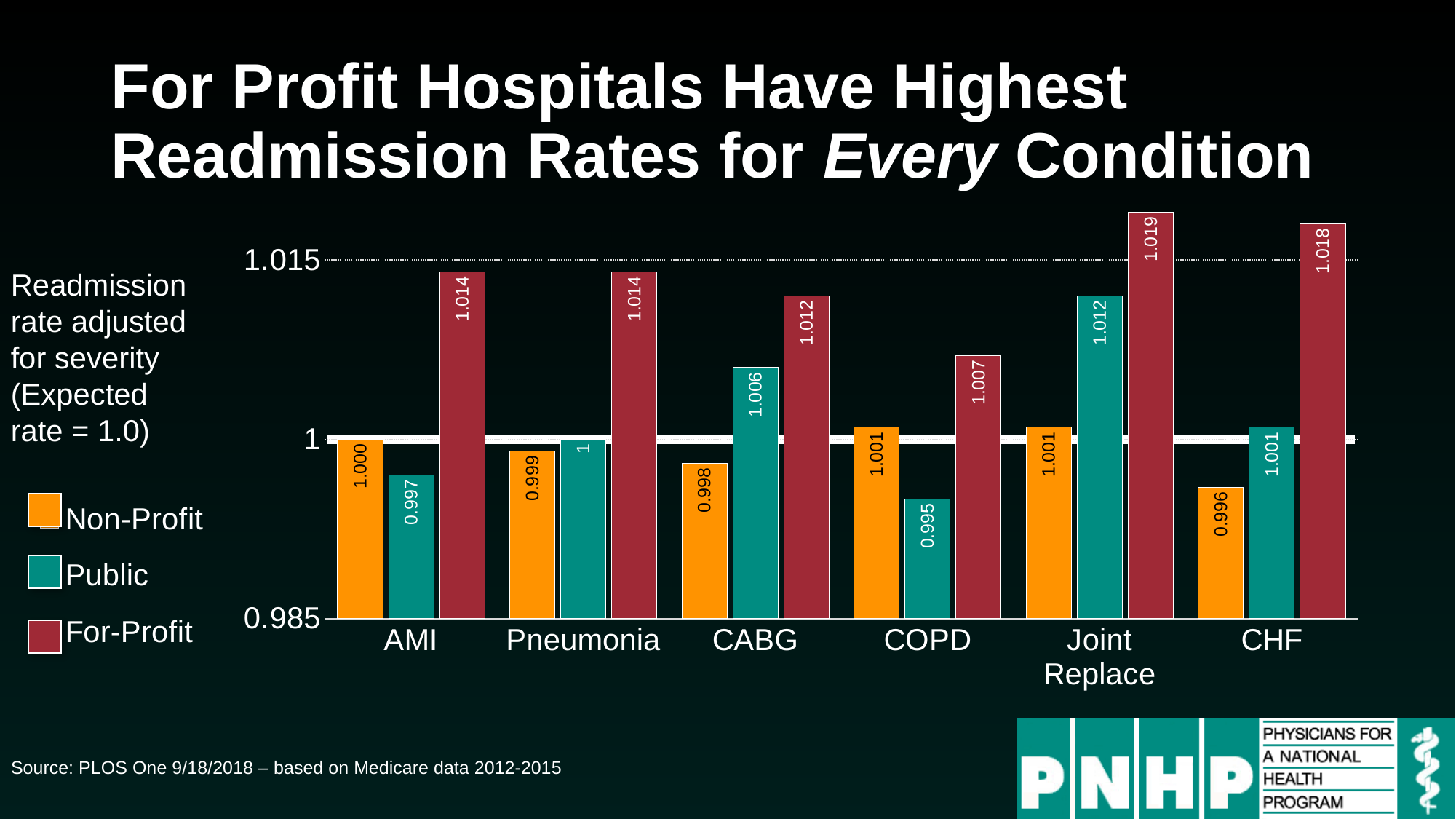
For CABG, which is larger: the Public rate or the Non-Profit rate? Public What kind of chart is shown on the slide? Bar chart What is the Public readmission rate for COPD? 0.995 How many conditions are shown on the x axis? 6 What is the For-Profit readmission rate for Joint Replace? 1.019 What is the Non-Profit readmission rate for CHF? 0.996 Which condition has the highest For-Profit readmission rate? Joint Replace What is the difference between the For-Profit and Non-Profit readmission rates for CHF? 0.022 Which condition has the lowest Public readmission rate? COPD Which colour represents the For-Profit series in the legend? Red Is the Public readmission rate for Joint Replace greater or less than 1? greater How many series does the legend list? 3